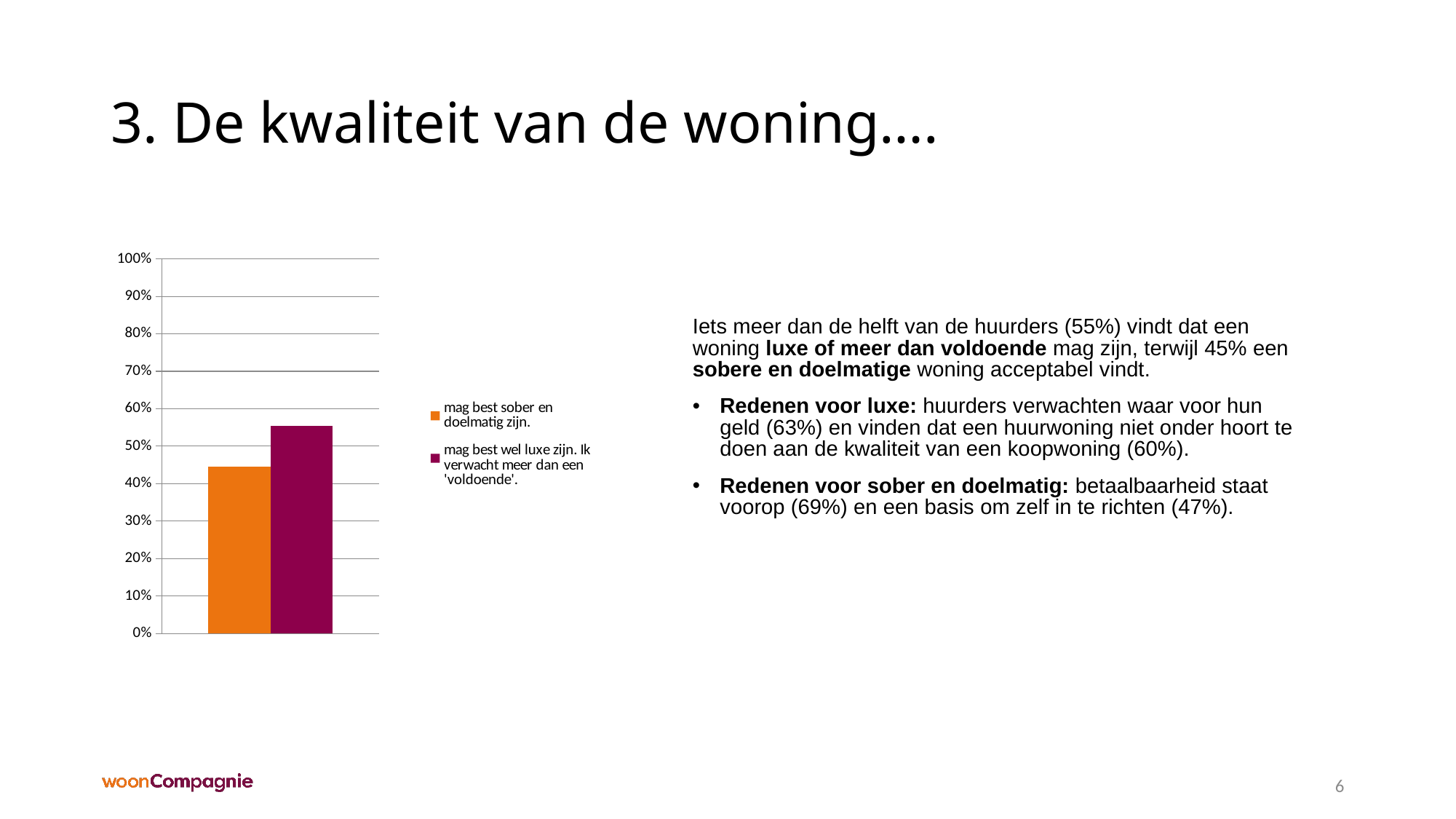
Is the value for 'mag best sober en doelmatig zijn.' greater or less than 50%? less How many bars are plotted in the chart? 2 How many series does the chart legend list? 2 Is the value for 'mag best sober en doelmatig zijn.' greater or less than 40%? greater Which series has the lowest bar in the chart? mag best sober en doelmatig zijn. Which bar is taller: 'mag best sober en doelmatig zijn.' or 'mag best wel luxe zijn. Ik verwacht meer dan een 'voldoende'.'? mag best wel luxe zijn. Ik verwacht meer dan een 'voldoende'. Is the value for 'mag best wel luxe zijn. Ik verwacht meer dan een 'voldoende'.' greater or less than 60%? less What colour is the bar for 'mag best sober en doelmatig zijn.'? orange Which series has the highest bar in the chart? mag best wel luxe zijn. Ik verwacht meer dan een 'voldoende'. What is the highest value shown on the chart's vertical axis? 100% What kind of chart is shown on the slide? bar chart